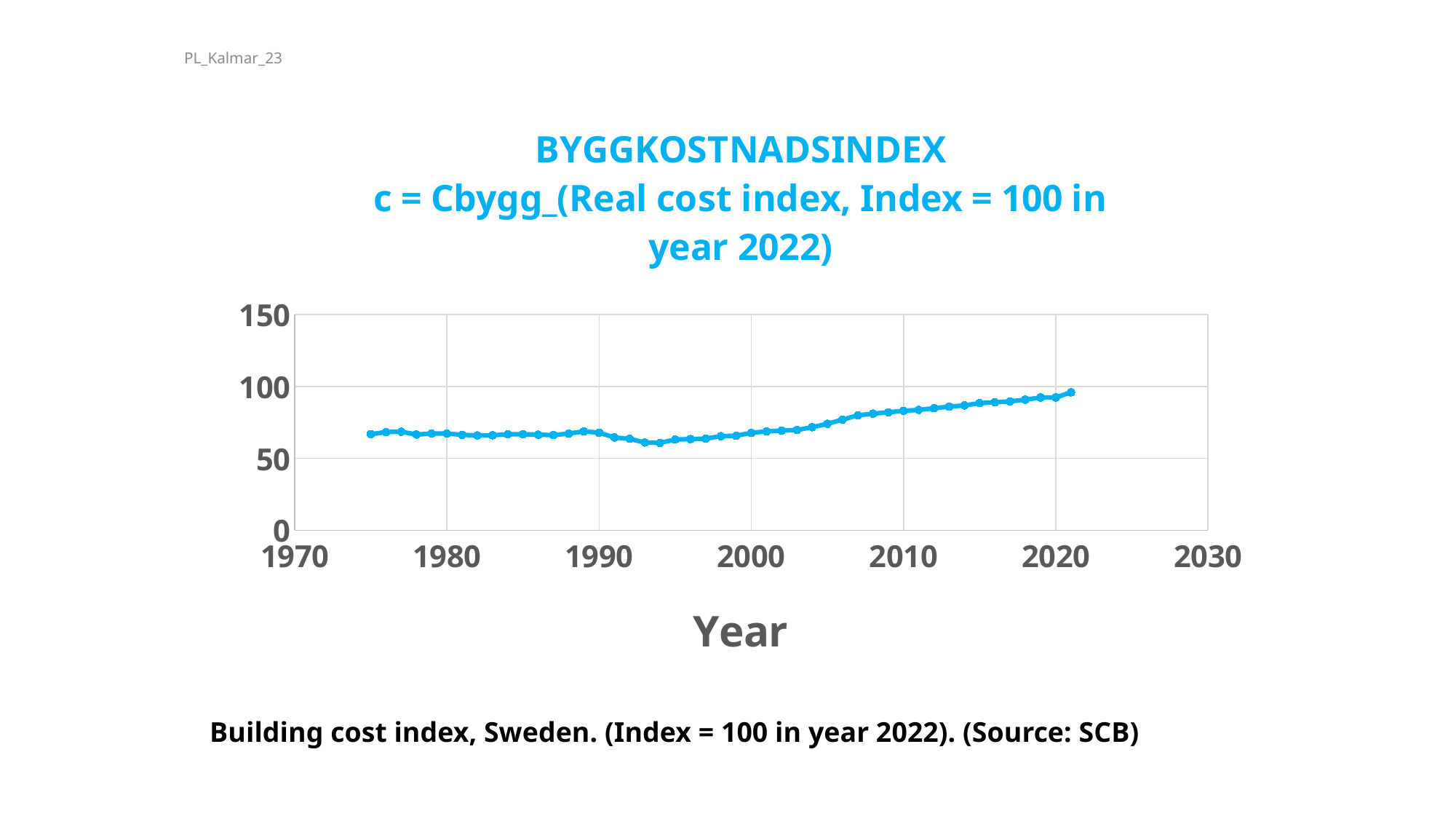
What kind of chart is shown on the slide? line chart Is the highest value of the series at the start or at the end of the plotted period? end Is the value for 1980 greater or less than 100? less Is the value for 2021 greater or less than 50? greater Do the values rise or fall along the x axis between 1990 and 1994? fall Which is larger, the value for 1975 or the value for 1994? 1975 What is the title of the x axis? Year Which is larger, the value for 2020 or the value for 1994? 2020 What is the first line of the chart title? BYGGKOSTNADSINDEX Do the values rise or fall along the x axis between 2000 and 2020? rise Is the value for 1994 greater or less than 100? less